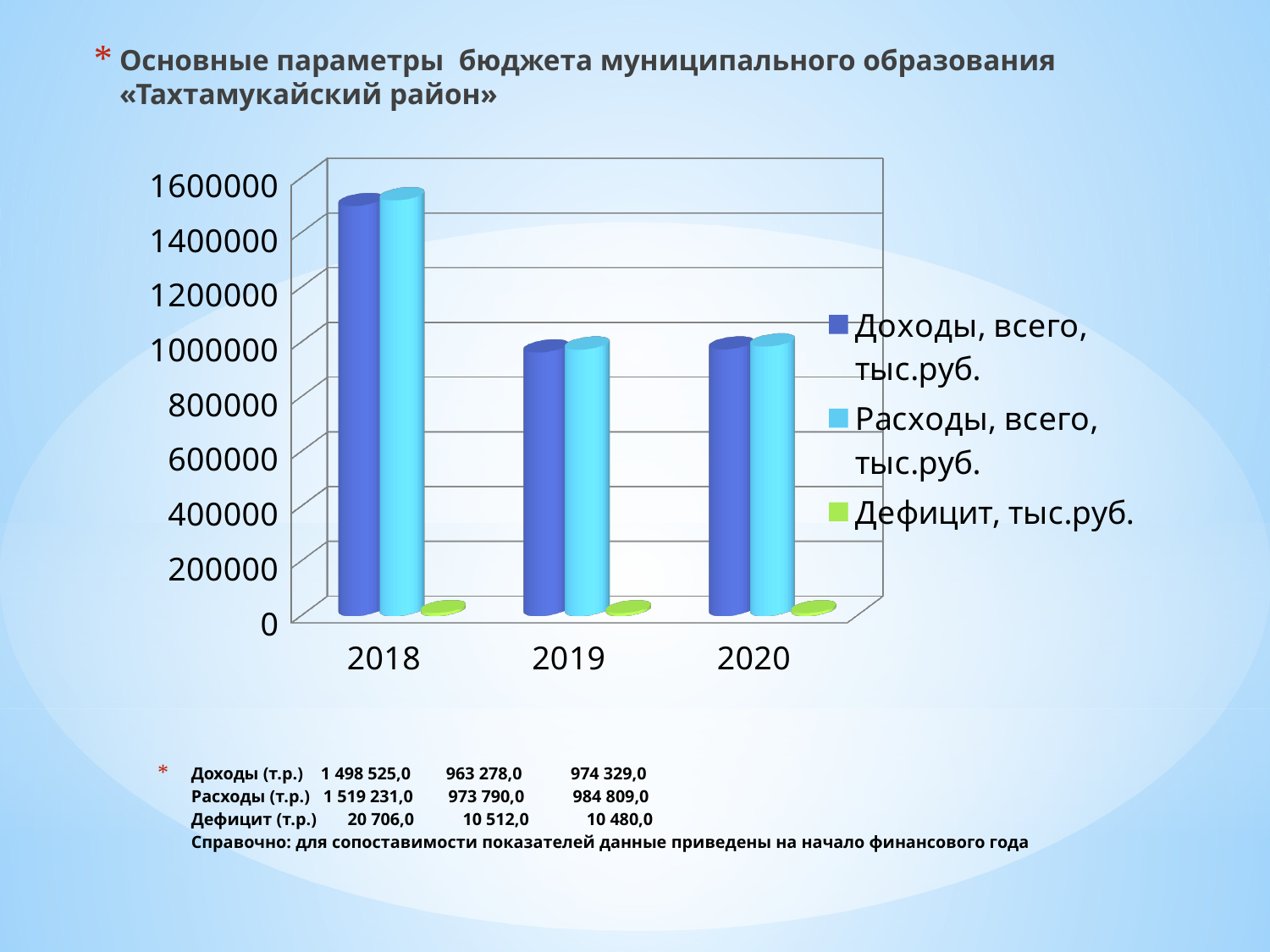
Is the value of Доходы, всего for 2019 greater or less than 1000000? less What is the difference between Расходы and Доходы in 2018? 20 706,0 What is the value of Доходы (т.р.) for 2018? 1 498 525,0 In which year is Расходы, всего the lowest? 2019 What is the value of Расходы (т.р.) for 2020? 984 809,0 What is the value of Дефицит (т.р.) for 2019? 10 512,0 Which is larger in 2020: Доходы, всего or Расходы, всего? Расходы, всего Which series is shown in green in the chart legend? Дефицит, тыс.руб. What kind of chart is shown on the slide? bar chart How many series does the chart legend list? 3 How many years are shown on the x axis of the chart? 3 In which year is Доходы, всего the highest? 2018